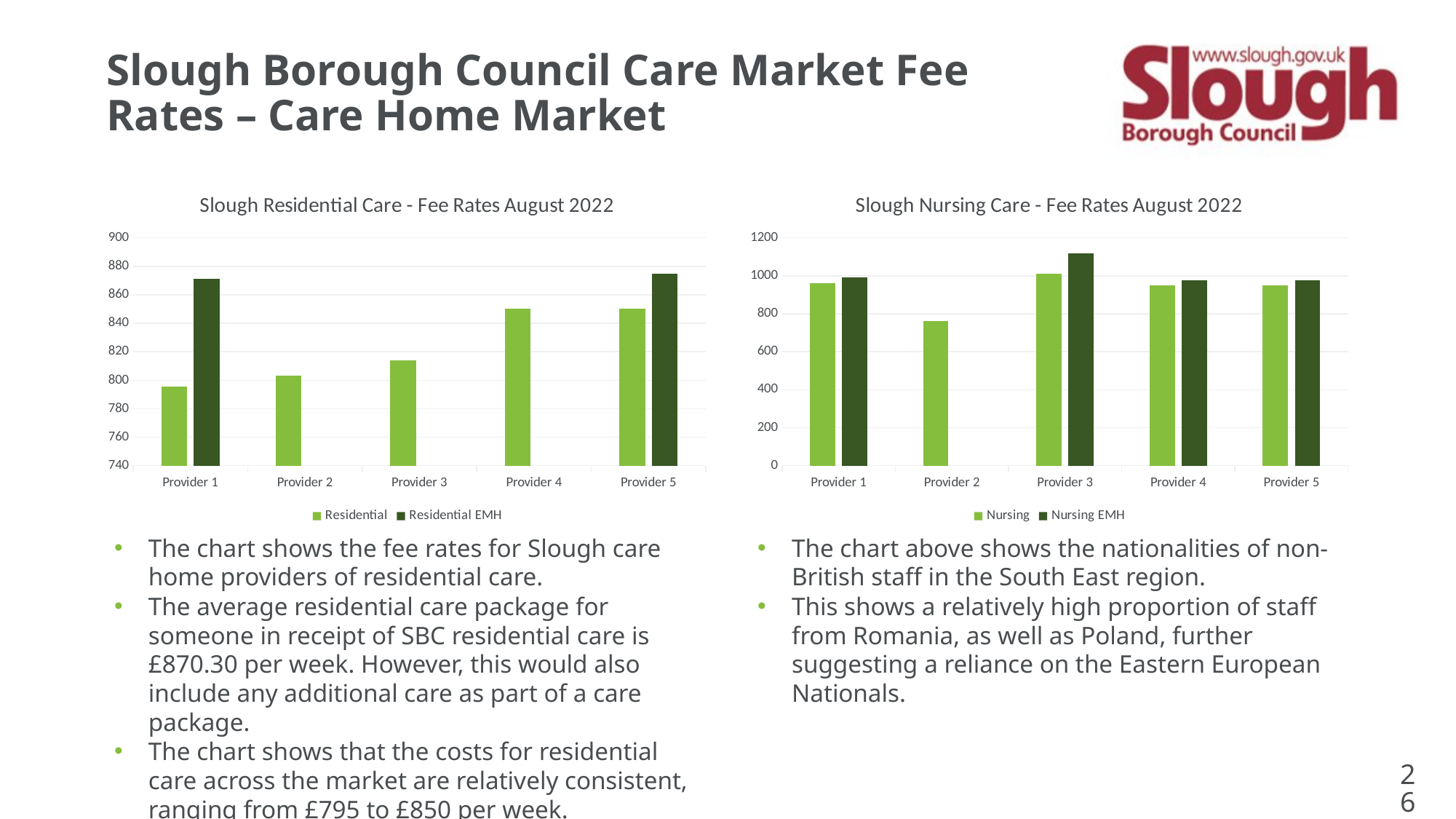
In the 'Slough Residential Care - Fee Rates August 2022' chart, which provider has the lowest Residential fee rate? Provider 1 In the 'Slough Residential Care - Fee Rates August 2022' chart, is the Residential EMH value for Provider 1 greater or less than 860? greater In the 'Slough Nursing Care - Fee Rates August 2022' chart, which provider has the lowest Nursing fee rate? Provider 2 What are the two legend entries of the 'Slough Nursing Care - Fee Rates August 2022' chart? Nursing and Nursing EMH In the 'Slough Nursing Care - Fee Rates August 2022' chart, is the Nursing EMH value for Provider 3 greater or less than 1000? greater In the 'Slough Nursing Care - Fee Rates August 2022' chart, is the Nursing value for Provider 2 greater or less than 800? less What kind of chart is the 'Slough Residential Care - Fee Rates August 2022' chart? bar chart In the 'Slough Nursing Care - Fee Rates August 2022' chart, which provider has the highest Nursing EMH fee rate? Provider 3 How many series does the legend of the 'Slough Residential Care - Fee Rates August 2022' chart list? 2 In the 'Slough Residential Care - Fee Rates August 2022' chart, which is larger for Provider 5: the Residential bar or the Residential EMH bar? Residential EMH How many providers are shown on the 'Slough Nursing Care - Fee Rates August 2022' chart? 5